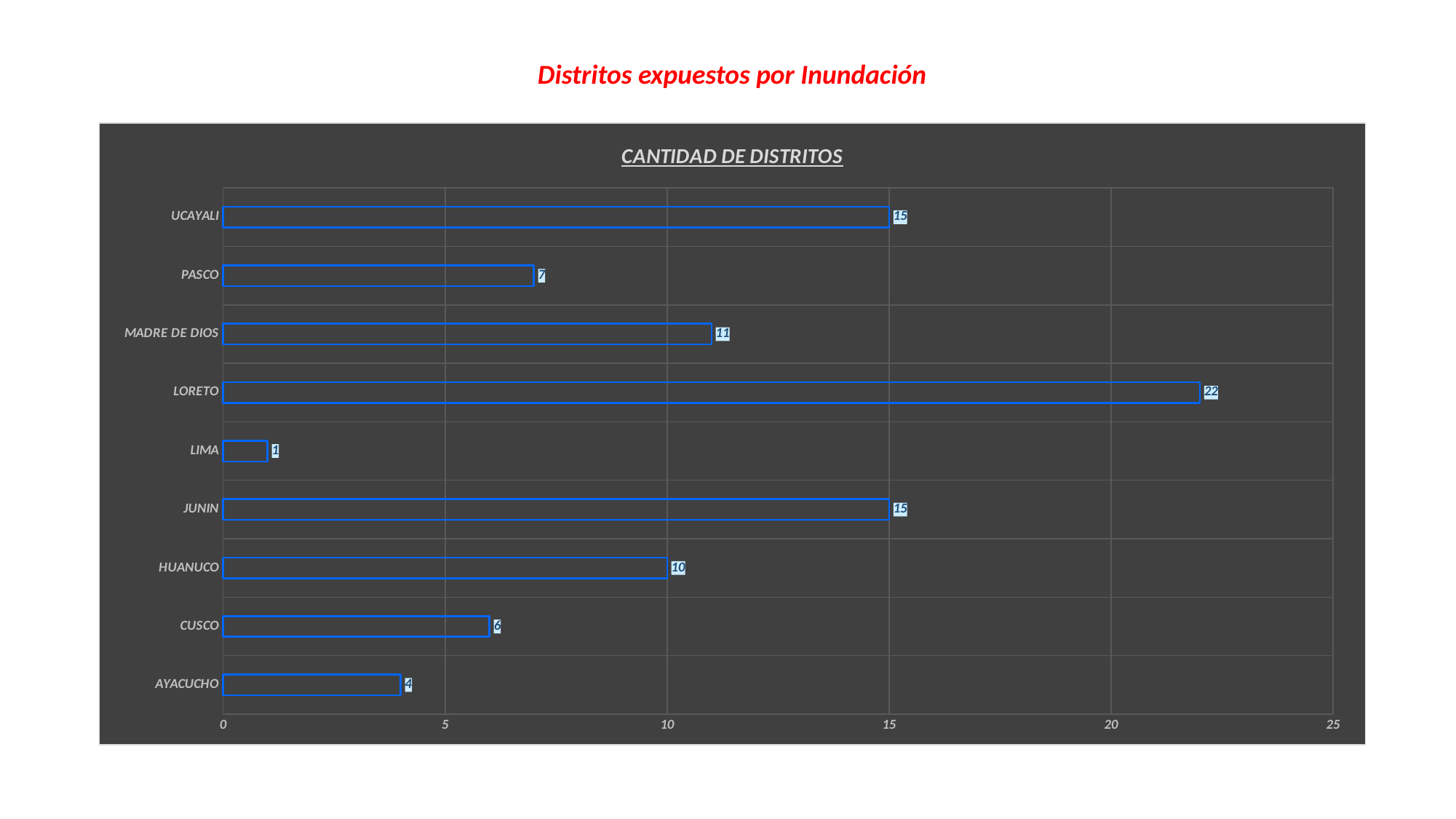
Which category has the lowest value? LIMA What is the value for AYACUCHO? 4 What is the title of the chart? CANTIDAD DE DISTRITOS What kind of chart is shown on the slide? bar chart Which is larger, the value for PASCO or the value for CUSCO? PASCO What is the maximum value shown on the horizontal axis? 25 How many categories are shown in the chart? 9 Is the value for JUNIN greater or less than 10? greater What is the difference between the values for LORETO and HUANUCO? 12 Which category has the highest value? LORETO What is the value for MADRE DE DIOS? 11 What is the value for LORETO? 22